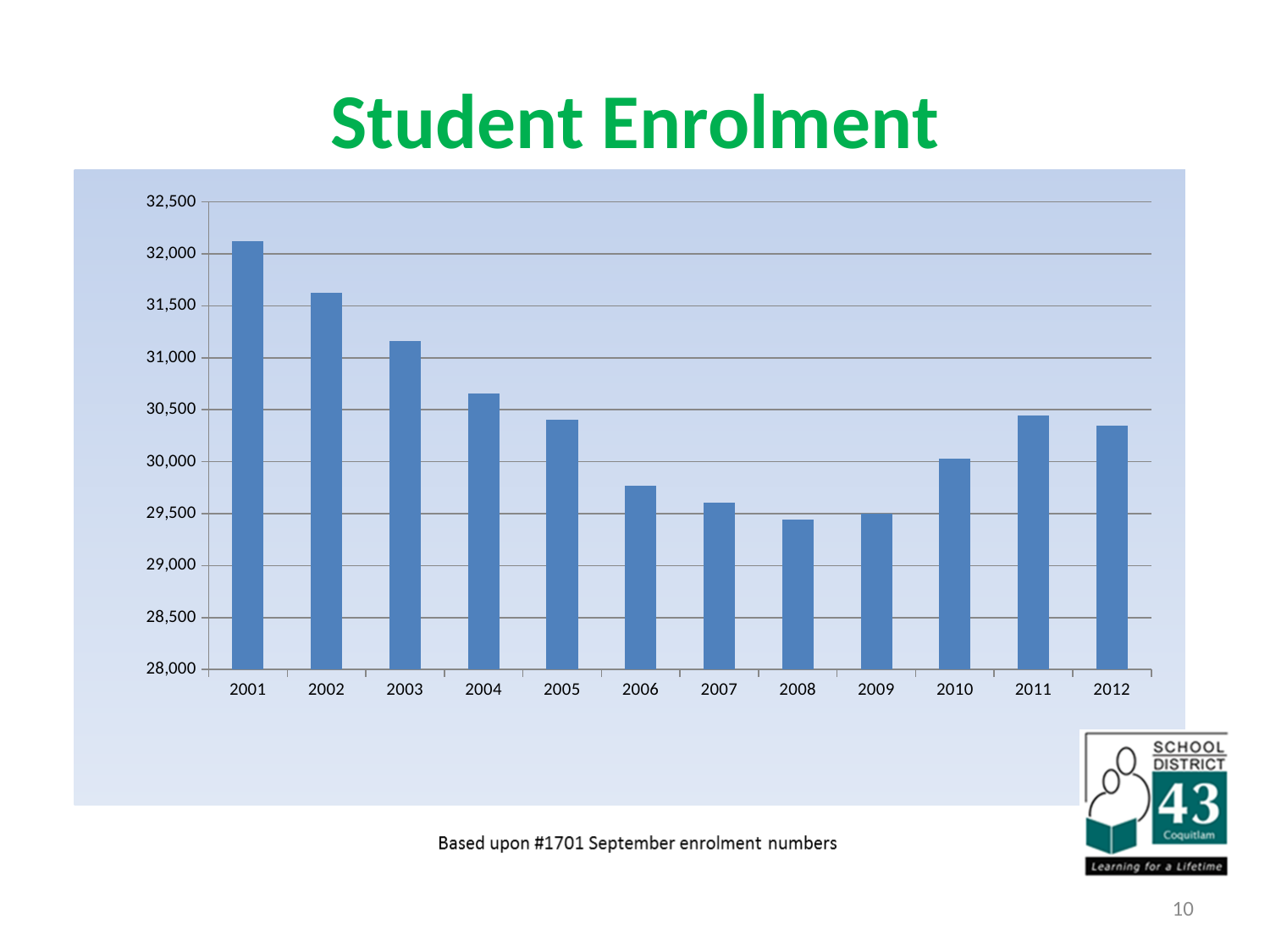
Do the values rise or fall from 2001 to 2008? fall What kind of chart is shown on the slide? bar chart Which is larger, the enrolment in 2010 or in 2011? 2011 Which is larger, the enrolment in 2001 or in 2012? 2001 Is the value for 2002 greater or less than 31,500? greater How many years are plotted on the x axis of the chart? 12 Which year has the highest student enrolment? 2001 Is the value for 2003 greater or less than 31,000? greater What is the title of the chart on the slide? Student Enrolment Is the value for 2001 greater or less than 32,000? greater